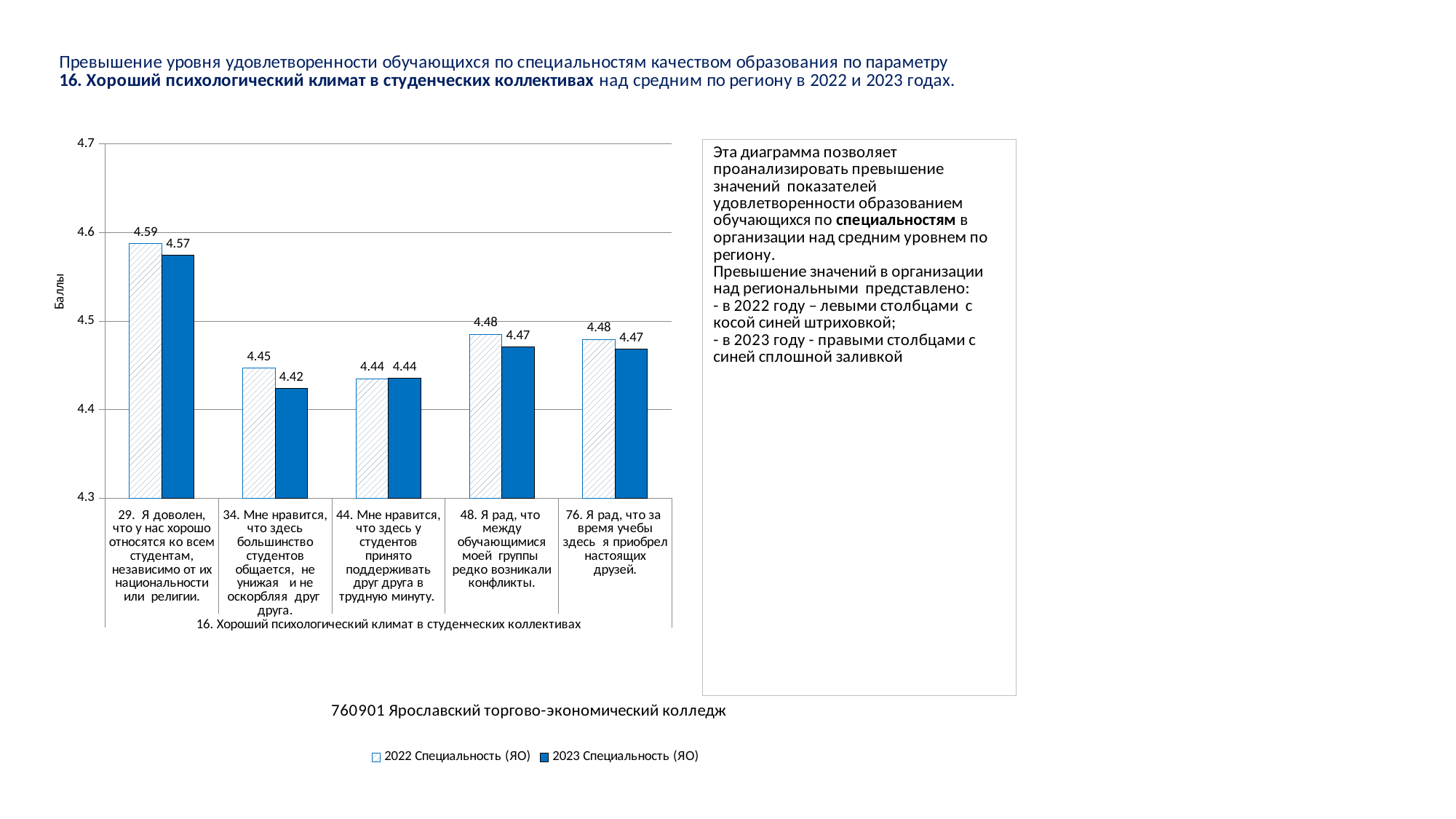
Which category has the lowest 2023 Специальность (ЯО) value? 34. Мне нравится, что здесь большинство студентов общается, не унижая и не оскорбляя друг друга What is the 2023 Специальность (ЯО) value for category "48. Я рад, что между обучающимися моей группы редко возникали конфликты"? 4.47 What is the difference between the 2022 and 2023 values for category "34. Мне нравится, что здесь большинство студентов общается..."? 0.03 For category "76. Я рад, что за время учебы здесь я приобрел настоящих друзей", which series has the larger value, 2022 or 2023? 2022 Специальность (ЯО) What is the label of the vertical axis of the chart? Баллы How many categories are shown on the x axis of the chart? 5 What is the difference between the 2022 and 2023 values for category "29. Я доволен, что у нас хорошо относятся ко всем студентам..."? 0.02 What is the 2023 Специальность (ЯО) value for category "34. Мне нравится, что здесь большинство студентов общается, не унижая и не оскорбляя друг друга"? 4.42 Is the 2023 Специальность (ЯО) value for category "34. Мне нравится, что здесь большинство студентов общается..." greater or less than 4.5? less Which category has the highest 2022 Специальность (ЯО) value? 29. Я доволен, что у нас хорошо относятся ко всем студентам, независимо от их национальности или религии What is the 2022 Специальность (ЯО) value for category "29. Я доволен, что у нас хорошо относятся ко всем студентам, независимо от их национальности или религии"? 4.59 How many series does the chart legend list? 2